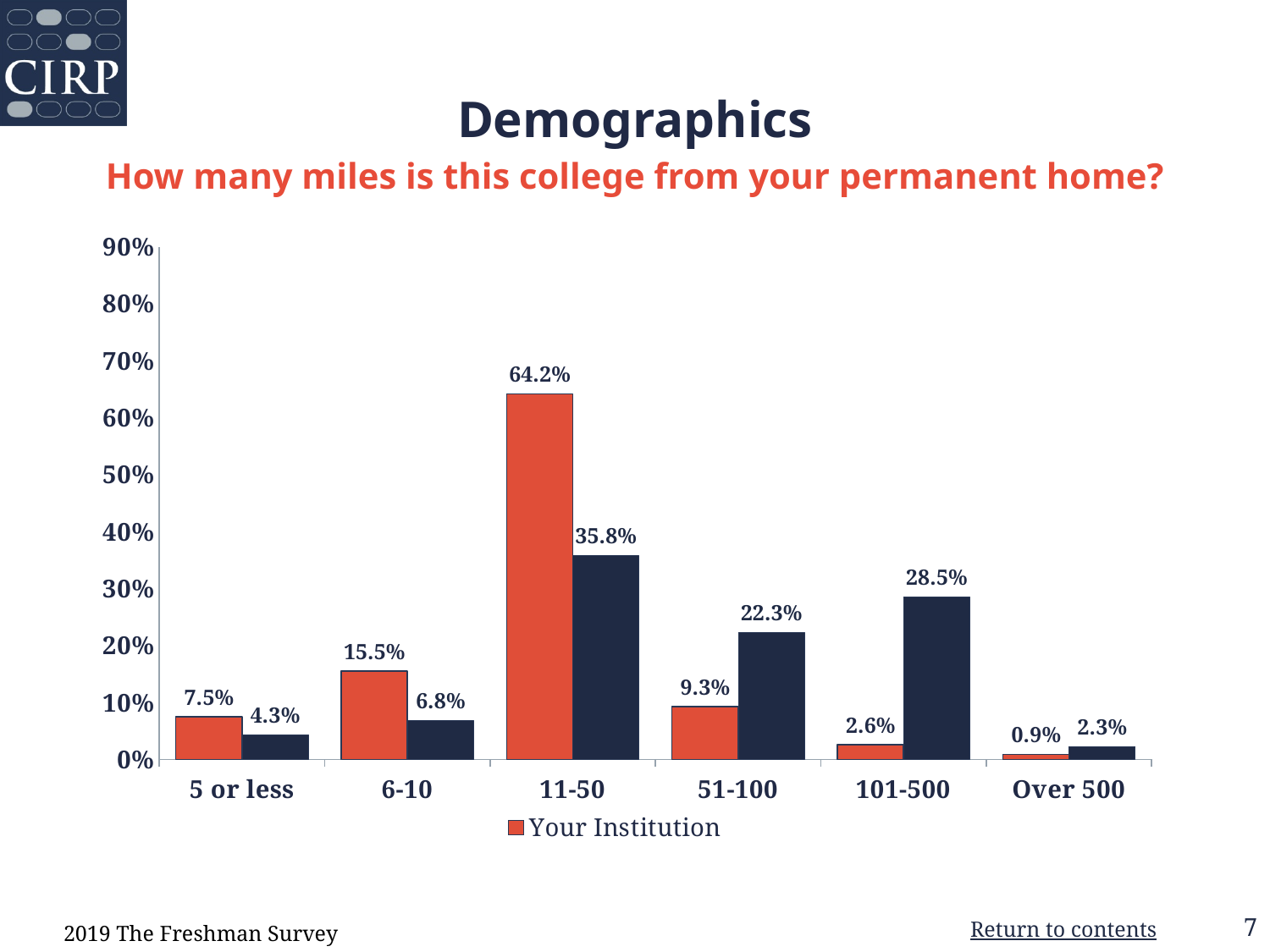
How many series does the legend list? 1 What is the red subtitle question shown above the chart? How many miles is this college from your permanent home? What is the value for Your Institution in the 11-50 category? 64.2% What is the difference between the Your Institution bar and the dark navy bar in the 11-50 category? 28.4% In the 51-100 category, which is larger: the Your Institution bar or the dark navy bar? the dark navy bar How many categories are shown on the x axis? 6 What is the value for Your Institution in the Over 500 category? 0.9% Which category has the lowest value for Your Institution? Over 500 What is the value for Your Institution in the 6-10 category? 15.5% Which category has the highest value for Your Institution? 11-50 What is the value of the dark navy bar in the 101-500 category? 28.5% What kind of chart is shown on the slide? bar chart